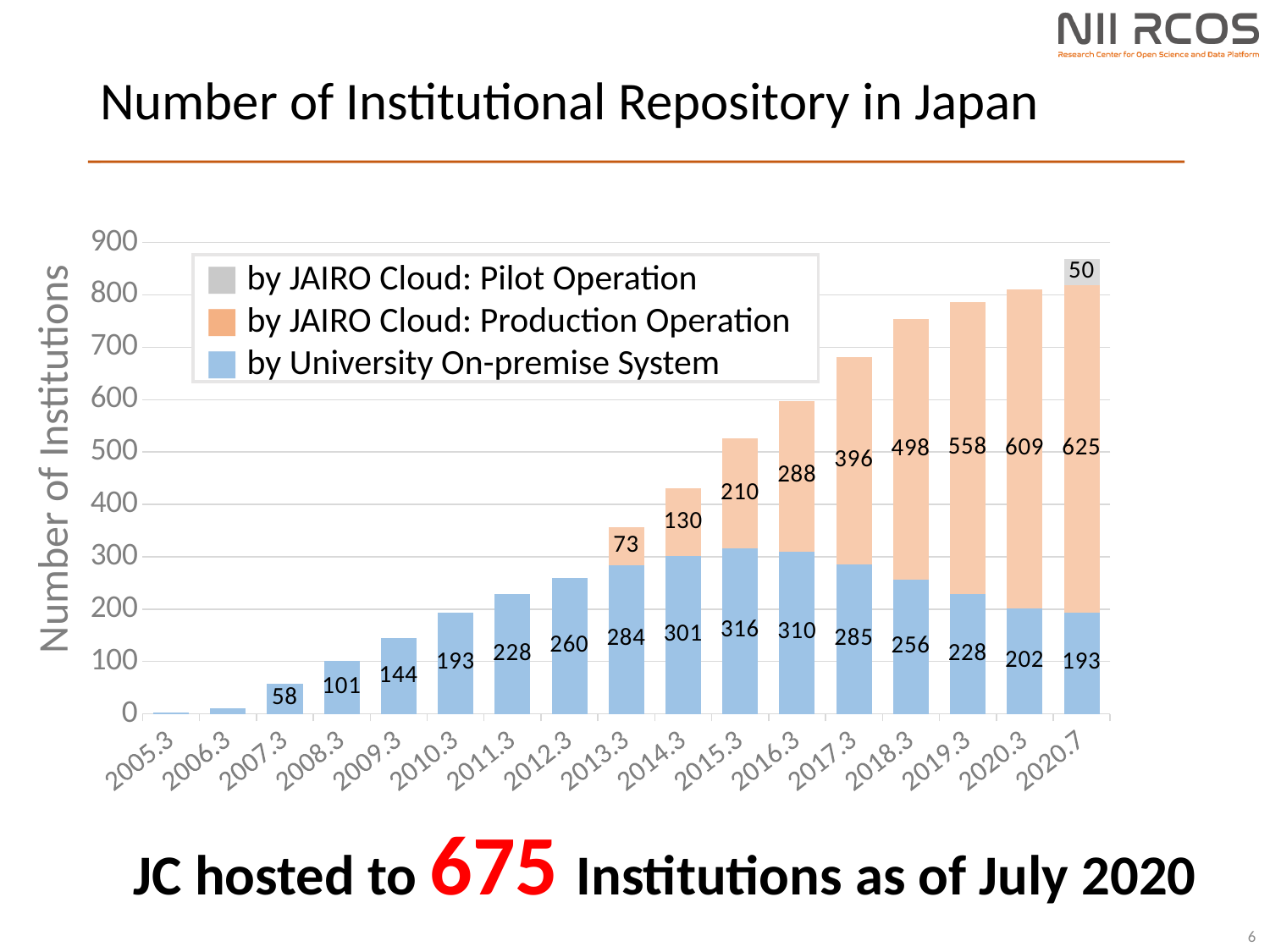
What is the total height of the stacked bar for 2020.7? 868 What is the value for 'by JAIRO Cloud: Pilot Operation' in 2020.7? 50 What type of chart is shown on the slide? stacked bar chart How many time points are shown on the x axis? 17 Does the 'by JAIRO Cloud: Production Operation' series rise or fall from 2013.3 to 2020.7? rise In which year is the 'by University On-premise System' value highest? 2015.3 What is the difference between the 'by JAIRO Cloud: Production Operation' values for 2020.7 and 2020.3? 16 In 2017.3, which is larger: 'by JAIRO Cloud: Production Operation' or 'by University On-premise System'? by JAIRO Cloud: Production Operation What is the value for 'by JAIRO Cloud: Production Operation' in 2018.3? 498 Is the total stacked bar for 2019.3 greater or less than 700? greater How many series does the legend list? 3 What is the value for 'by University On-premise System' in 2015.3? 316